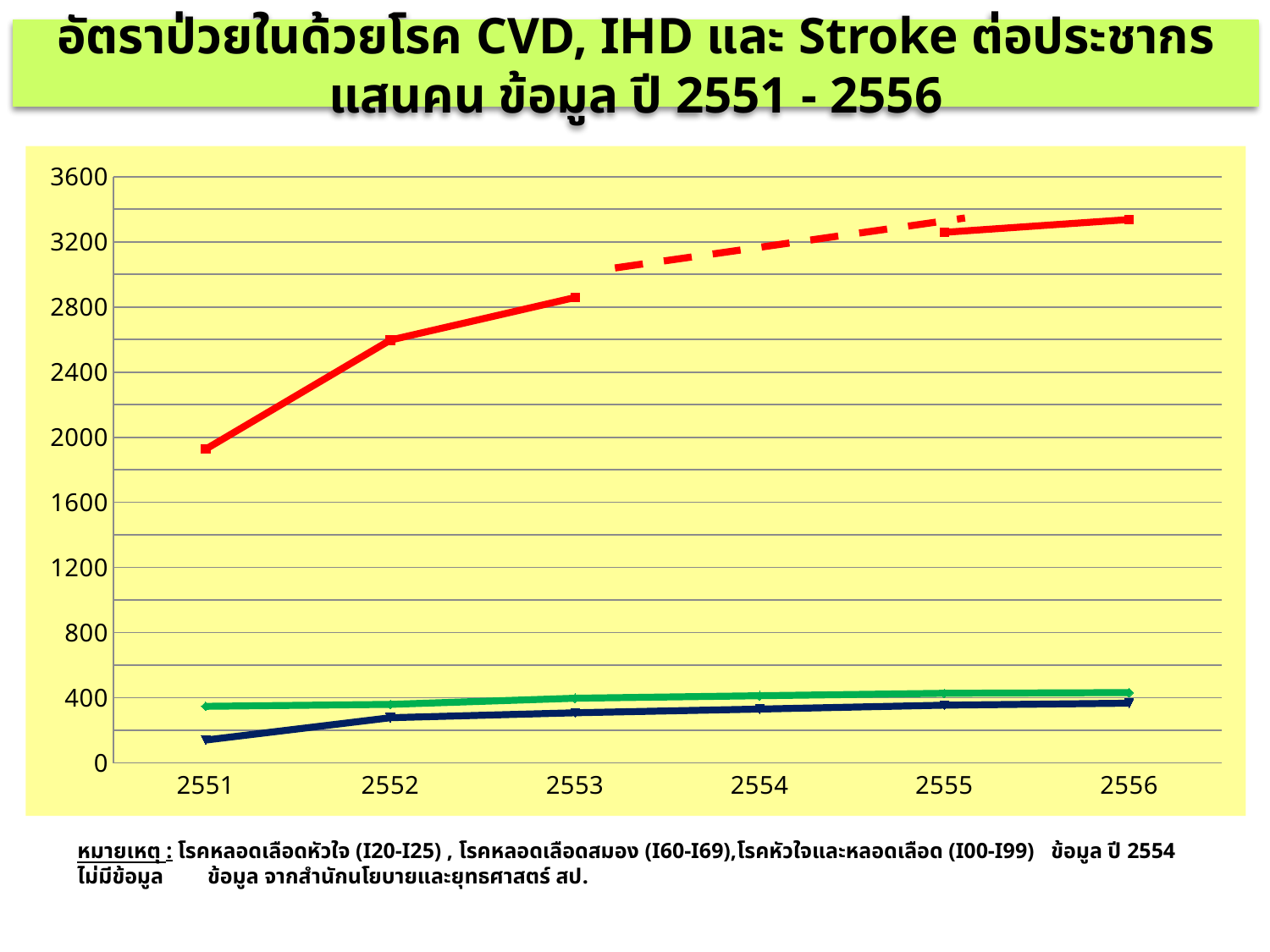
Is the value of the green line in 2556 greater or less than 800? less Is the value of the red line in 2556 greater or less than 3200? greater Which line has the highest values across all years: the red, green or navy line? red Is the value of the red line in 2551 greater or less than 2000? less Which line has the lowest value in 2551: the red, green or navy line? navy Between which two years is the red line drawn as a dashed segment? 2553 and 2555 In 2556, which is larger: the value of the red line or the value of the green line? red line Does the red line rise or fall from 2551 to 2556? rise What kind of chart is shown on the slide? line chart How many years are shown on the x axis of the chart? 6